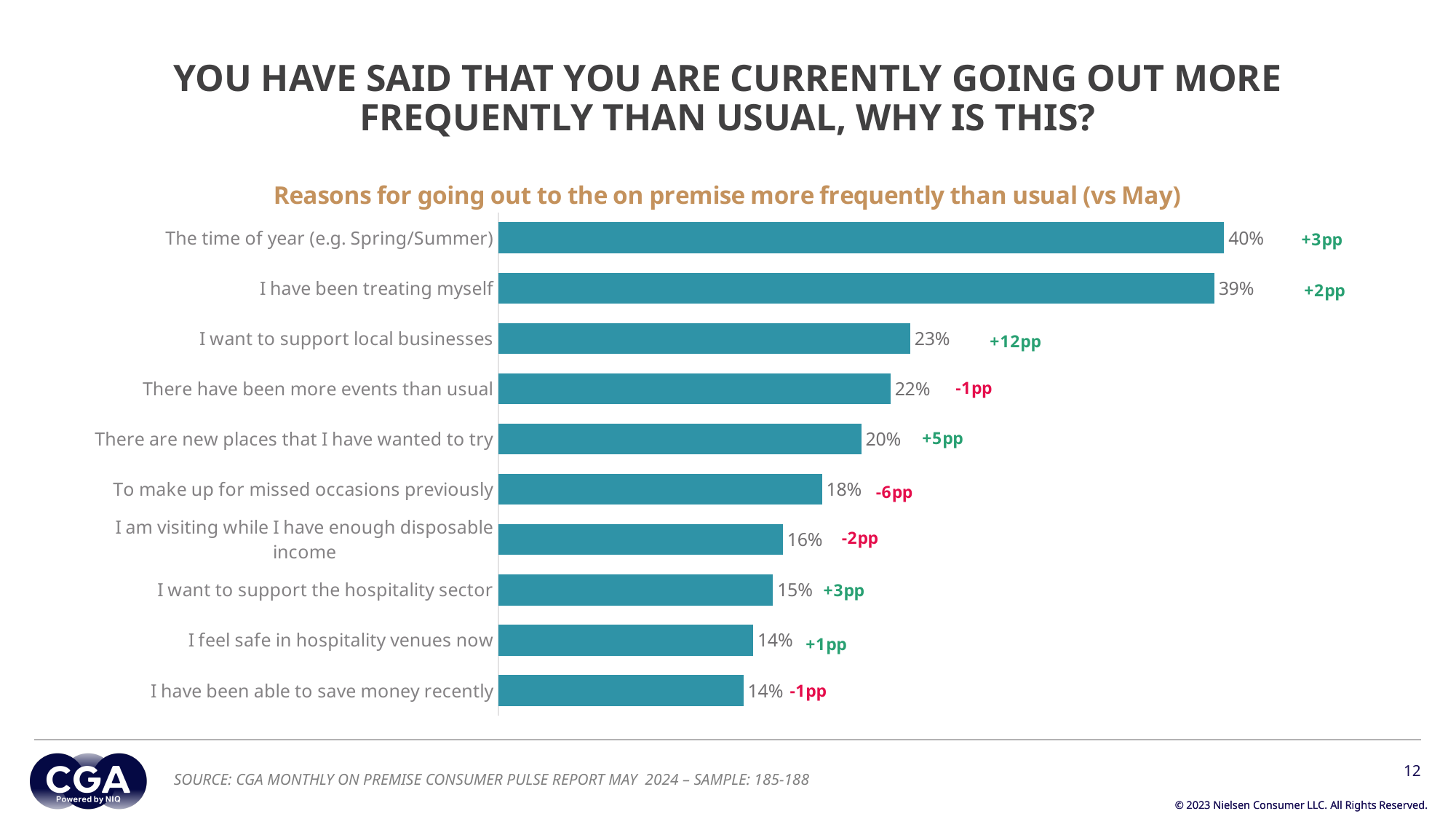
What is the change vs May shown for 'To make up for missed occasions previously'? -6pp What is the value for 'I feel safe in hospitality venues now'? 14% What percentage of respondents cited 'The time of year (e.g. Spring/Summer)' as a reason for going out more frequently? 40% What is the difference in percentage points between 'I have been treating myself' and 'There have been more events than usual'? 17 percentage points What kind of chart is shown on the slide? Bar chart What is the title of the chart? Reasons for going out to the on premise more frequently than usual (vs May) Which reason has the highest percentage? The time of year (e.g. Spring/Summer) What is the value for 'I want to support local businesses'? 23% What is the change vs May shown for 'I want to support local businesses'? +12pp How many reasons (categories) are shown in the chart? 10 What is the value for 'To make up for missed occasions previously'? 18% Which is larger: the value for 'There are new places that I have wanted to try' or the value for 'I am visiting while I have enough disposable income'? There are new places that I have wanted to try